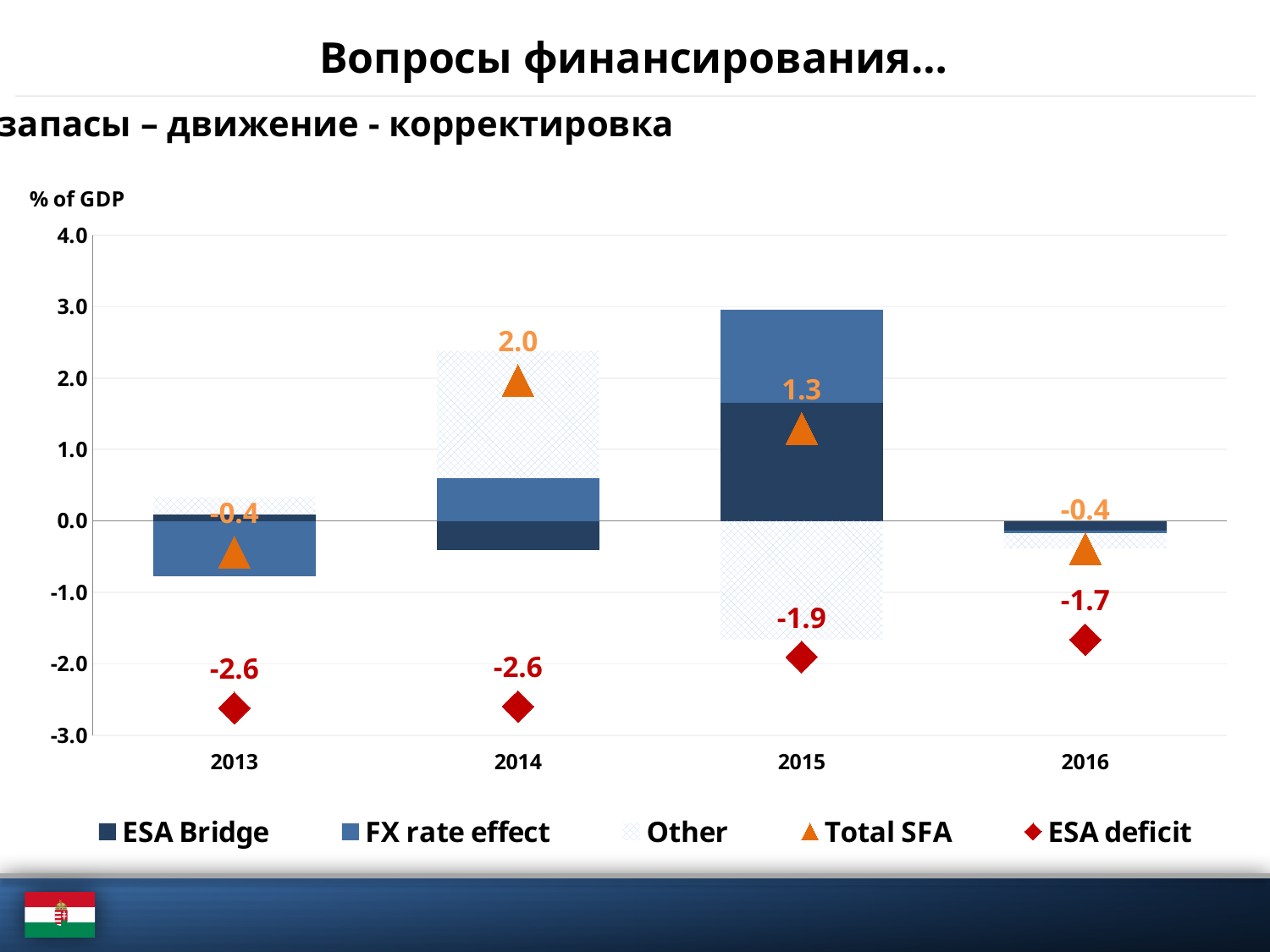
What is the Total SFA value for 2016? -0.4 Which year has the larger Total SFA value, 2013 or 2015? 2015 Is the ESA Bridge bar for 2015 greater or less than 1.0? greater What is the difference between Total SFA in 2014 and in 2015? 0.7 What is the Total SFA value for 2014? 2.0 What is the ESA deficit value for 2013? -2.6 In which year is Total SFA highest? 2014 In which year is the ESA deficit value highest (least negative)? 2016 How many series does the legend list? 5 What is the ESA deficit value for 2015? -1.9 How many years are shown on the x axis? 4 What is the difference between the ESA deficit in 2016 and in 2015? 0.2